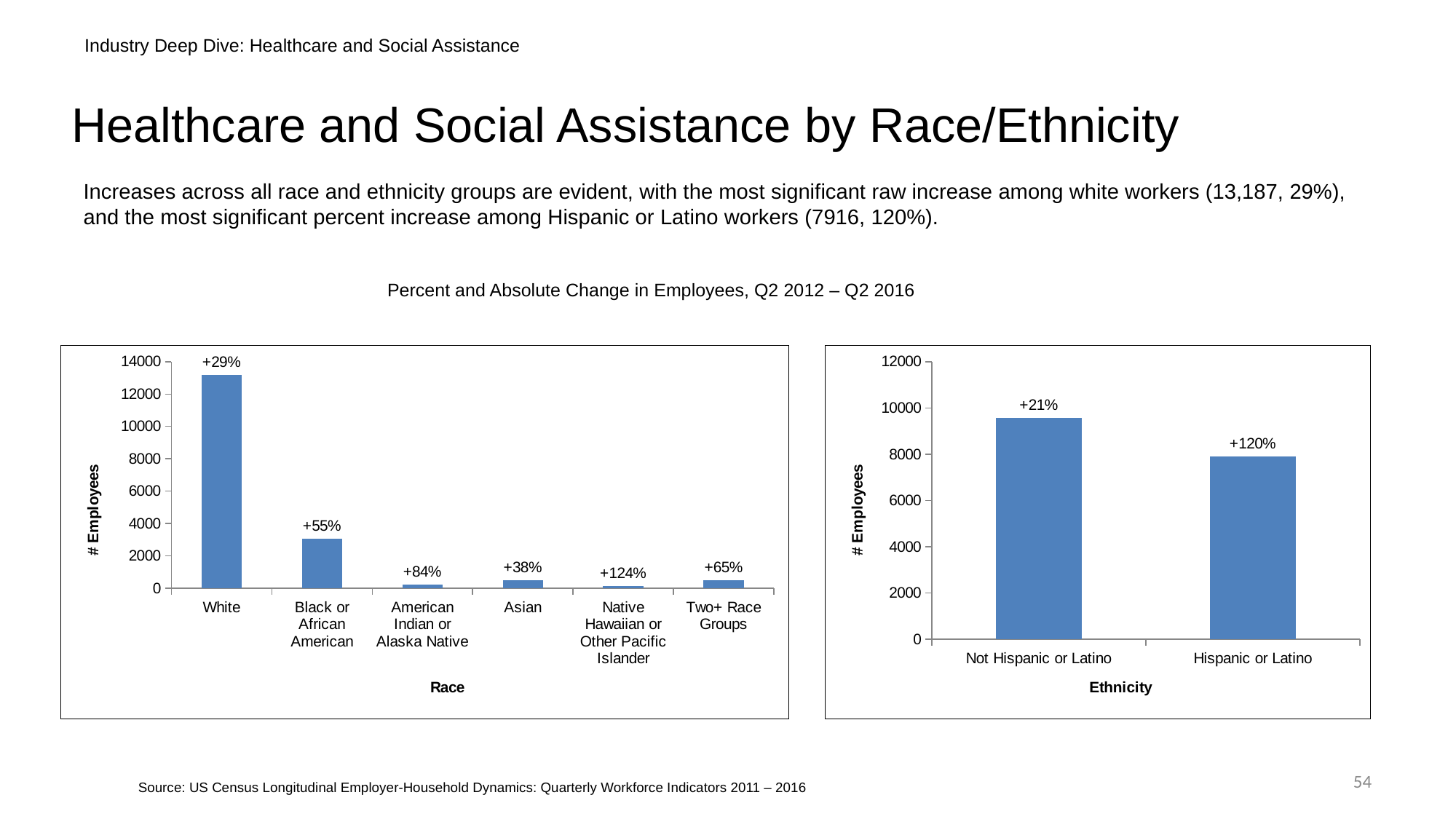
In the right chart (Ethnicity), what percent change label is shown above the Hispanic or Latino bar? +120% In the left chart (Race), how many race categories are shown on the x axis? 6 In the left chart (Race), what percent change label is shown above the White bar? +29% In the left chart (Race), what percent change label is shown above the Native Hawaiian or Other Pacific Islander bar? +124% In the right chart (Ethnicity), is the value for Not Hispanic or Latino greater or less than 8000? greater In the left chart (Race), which race category has the tallest bar? White In the left chart (Race), which bar is taller, White or Asian? White What type of chart is the right chart (Ethnicity)? Bar chart In the right chart (Ethnicity), what percent change label is shown above the Not Hispanic or Latino bar? +21% In the left chart (Race), what percent change label is shown above the Black or African American bar? +55% In the left chart (Race), is the value for Black or African American greater or less than 4000? less In the left chart (Race), is the value for White greater or less than 12000? greater